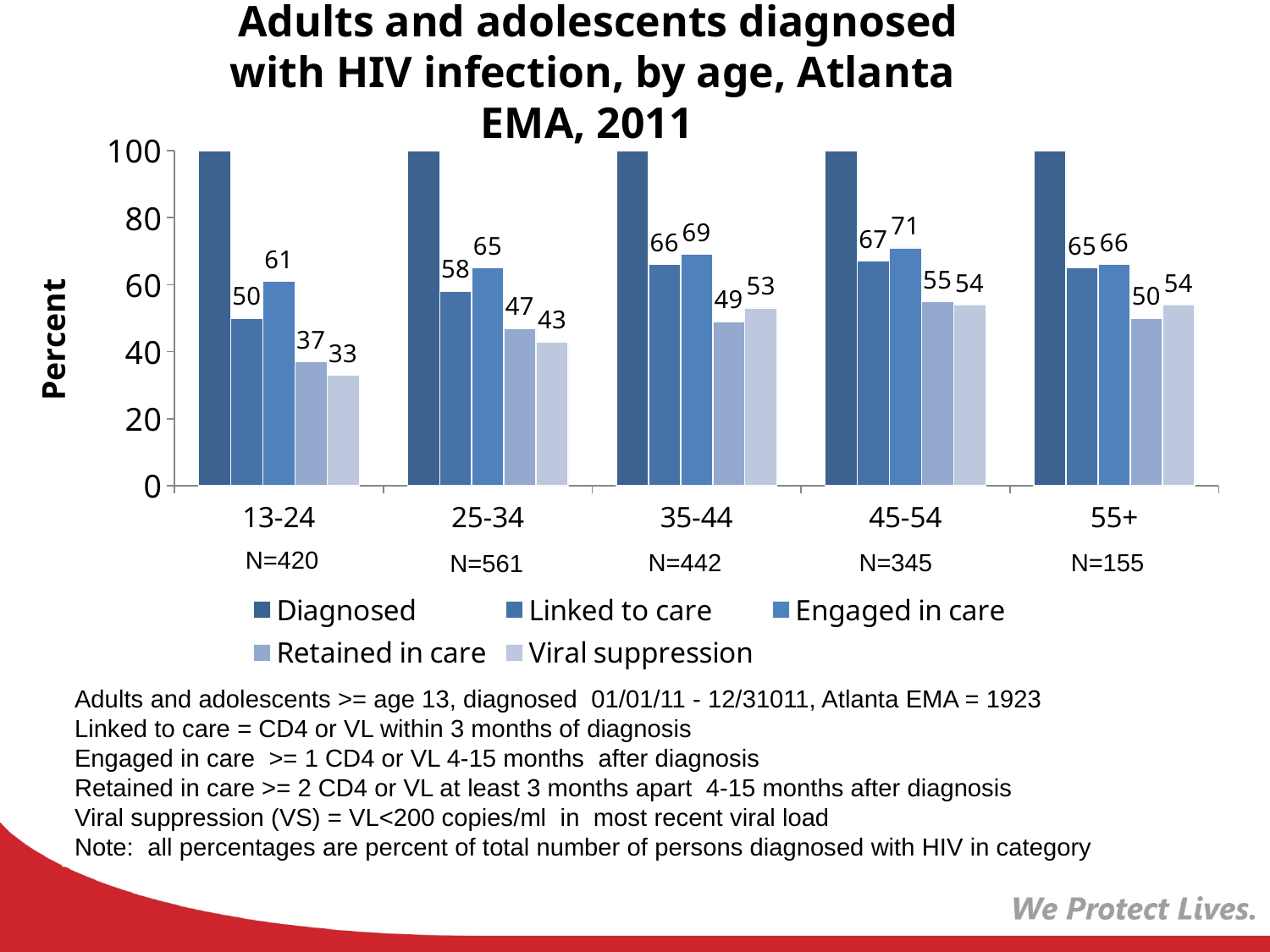
Which is larger for the 55+ age group: Retained in care or Viral suppression? Viral suppression How many age groups are shown on the x axis? 5 What is the N value shown for the 25-34 age group? N=561 What is the Engaged in care value for the 45-54 age group? 71 What kind of chart is shown on the slide? bar chart How many series does the legend list? 5 What is the difference between the Linked to care and Viral suppression values for the 35-44 age group? 13 Which age group has the highest Engaged in care value? 45-54 Which age group has the lowest Viral suppression value? 13-24 What is the Retained in care value for the 25-34 age group? 47 What is the label on the y axis? Percent What is the Viral suppression value for the 13-24 age group? 33